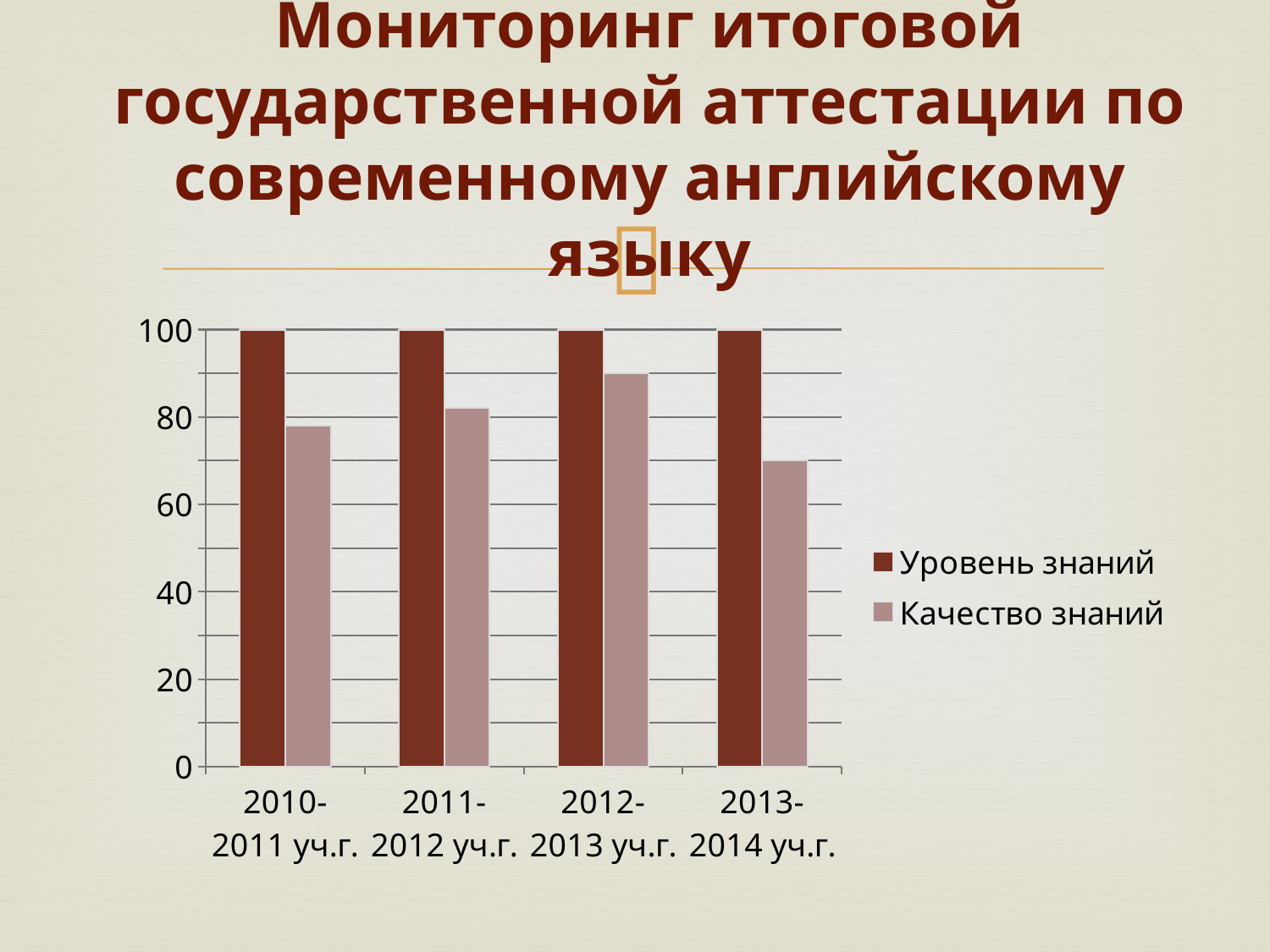
Is the value of Качество знаний for 2011-2012 уч.г. greater or less than 80? greater Which series is shown in the darker red colour in the legend? Уровень знаний Is the value of Качество знаний for 2013-2014 уч.г. greater or less than 80? less Is the value of Качество знаний for 2010-2011 уч.г. greater or less than 80? less How many academic years (categories) are shown on the x axis? 4 How many series does the legend list? 2 What is the value of Уровень знаний for 2010-2011 уч.г.? 100 What is the value of Уровень знаний for 2013-2014 уч.г.? 100 In which academic year is Качество знаний lowest? 2013-2014 уч.г. Which is larger: Качество знаний for 2012-2013 уч.г. or for 2013-2014 уч.г.? 2012-2013 уч.г. What kind of chart is shown on the slide? bar chart In which academic year is Качество знаний highest? 2012-2013 уч.г.